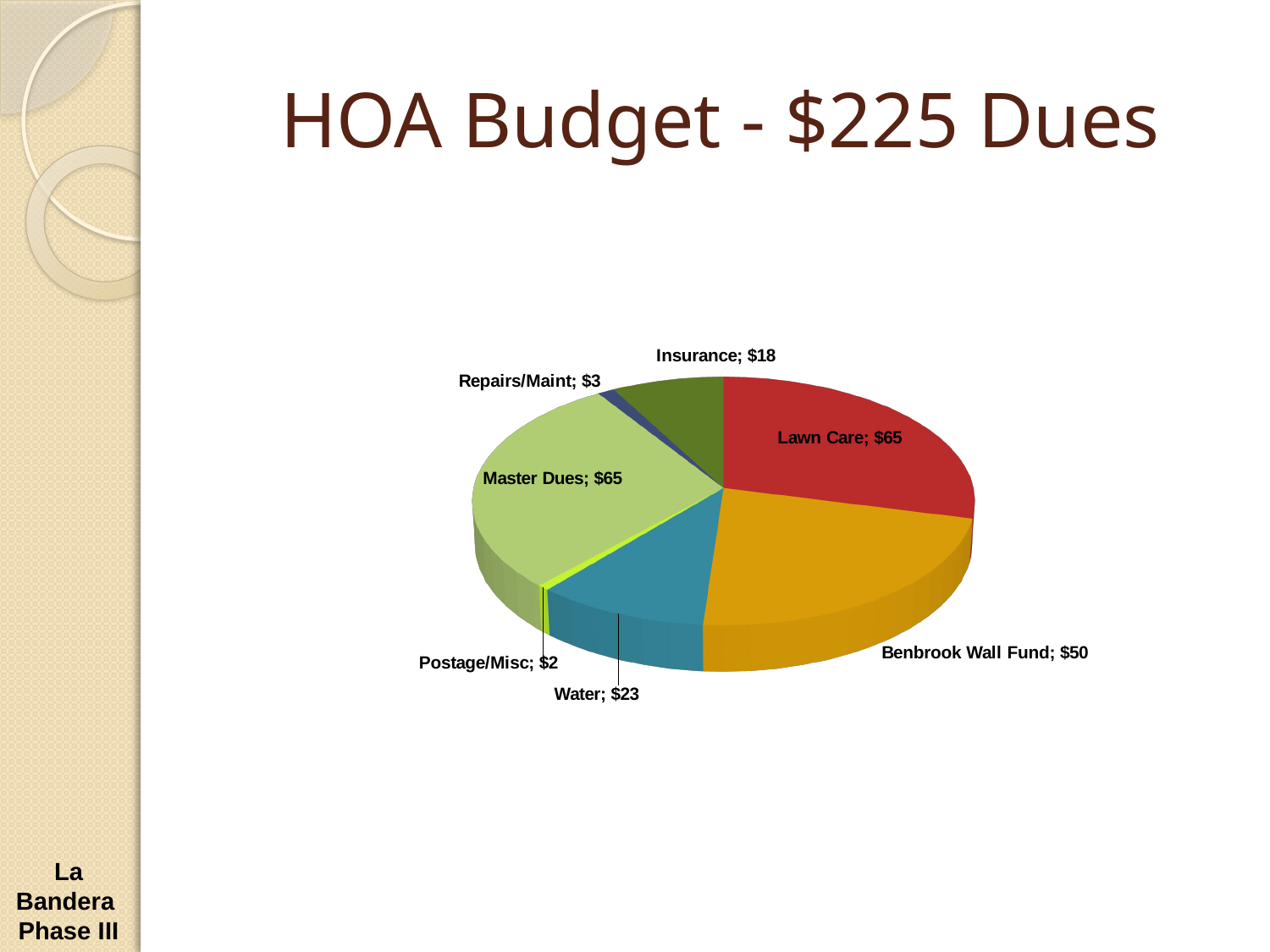
What is the value for Repairs/Maint? $3 Which category has the smallest slice? Postage/Misc What is the value for Insurance? $18 Which is larger, Water or Insurance? Water What is the title of the chart slide? HOA Budget - $225 Dues How many categories are shown in the pie chart? 7 What is the difference between Water and Insurance? $5 What is the difference between Lawn Care and Benbrook Wall Fund? $15 What is the value for Lawn Care? $65 What is the value for Benbrook Wall Fund? $50 What kind of chart is shown on the slide? pie chart What is the value for Water? $23